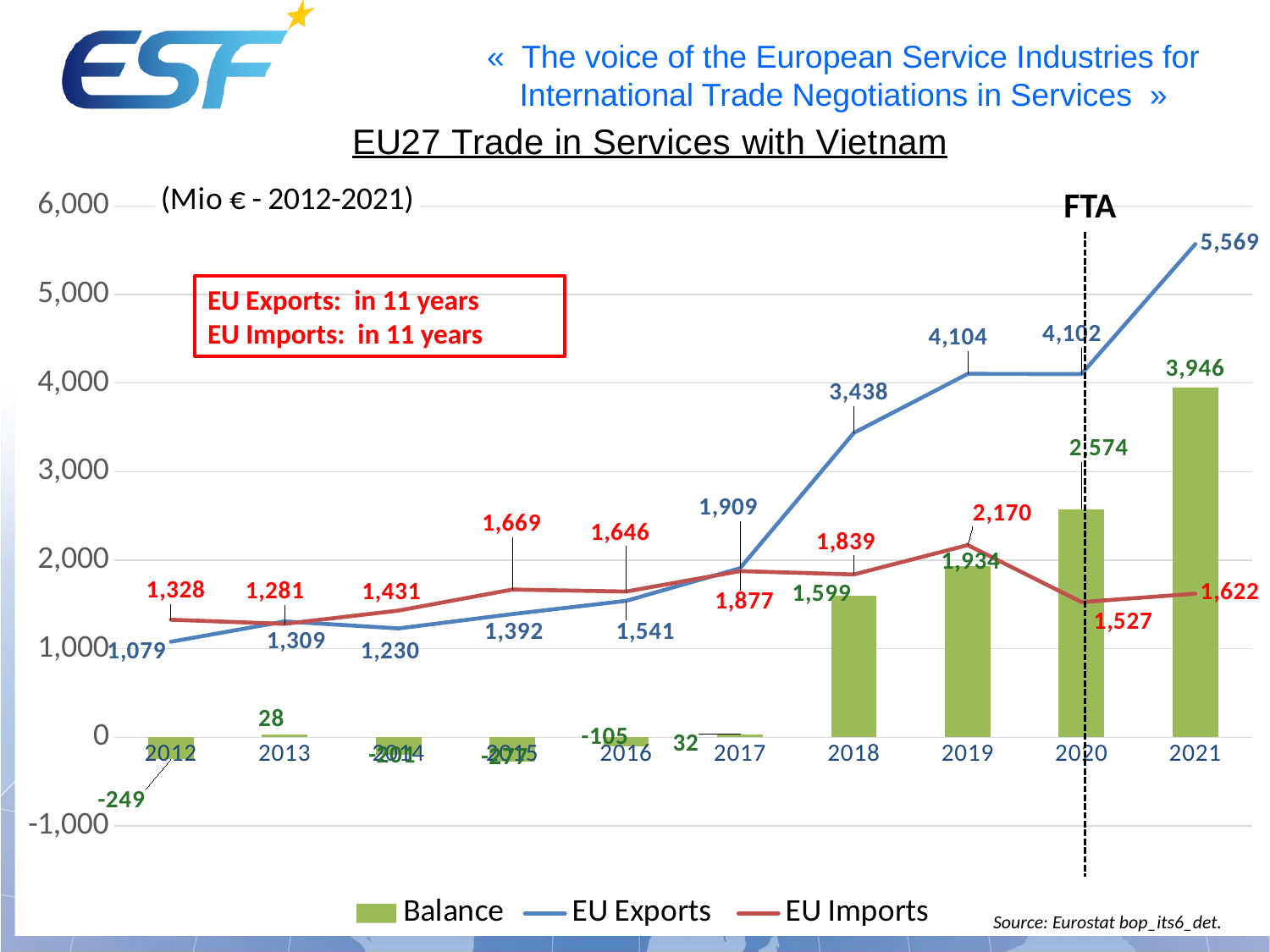
In which year are EU Imports highest? 2019 What is the value of EU Exports in 2021? 5,569 Is the value for EU Exports in 2018 greater or less than 3,000? greater By how much did EU Exports increase from 2020 to 2021? 1,467 What is the value of EU Imports in 2019? 2,170 What is the Balance value shown for 2020? 2,574 How many years are shown on the x axis? 10 How many series does the legend list? 3 In 2012, which is larger: EU Exports or EU Imports? EU Imports What kind of chart is this? Combined bar and line chart What is the difference between EU Exports and EU Imports in 2019? 1,934 In which year are EU Exports lowest? 2012